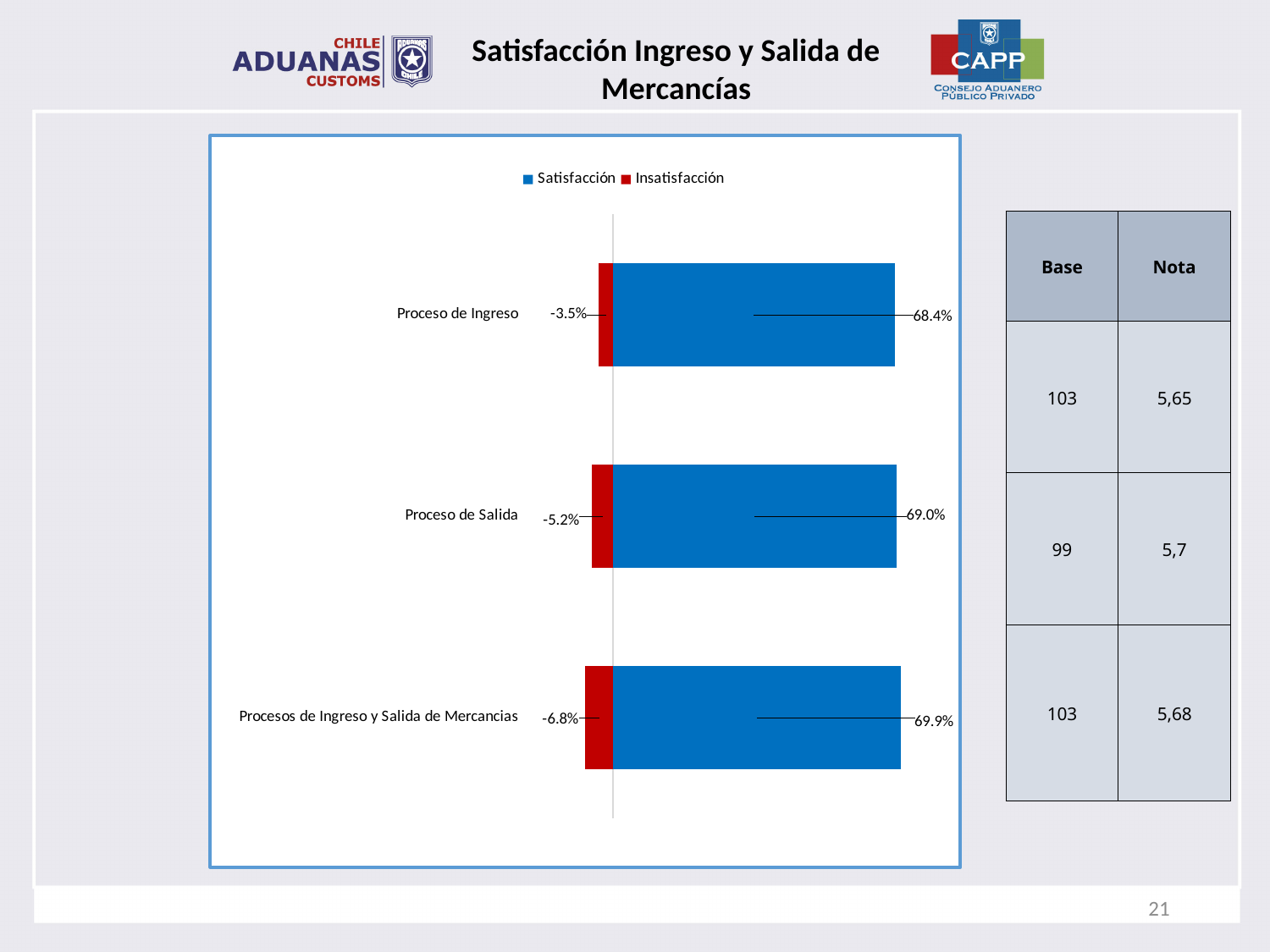
What kind of chart is shown on the slide? Bar chart What is the Insatisfacción value for Proceso de Salida? -5.2% Which has a larger Satisfacción value, Proceso de Salida or Proceso de Ingreso? Proceso de Salida Which category has the lowest Satisfacción value? Proceso de Ingreso How many categories are shown in the chart? 3 What is the Satisfacción value for Procesos de Ingreso y Salida de Mercancias? 69.9% Which colour represents Insatisfacción in the chart? Red What is the Satisfacción value for Proceso de Ingreso? 68.4% What is the difference in Satisfacción between Procesos de Ingreso y Salida de Mercancias and Proceso de Ingreso? 1.5 percentage points What is the Insatisfacción value for Proceso de Ingreso? -3.5% Which category has the highest Satisfacción value? Procesos de Ingreso y Salida de Mercancias How many series does the legend list? 2